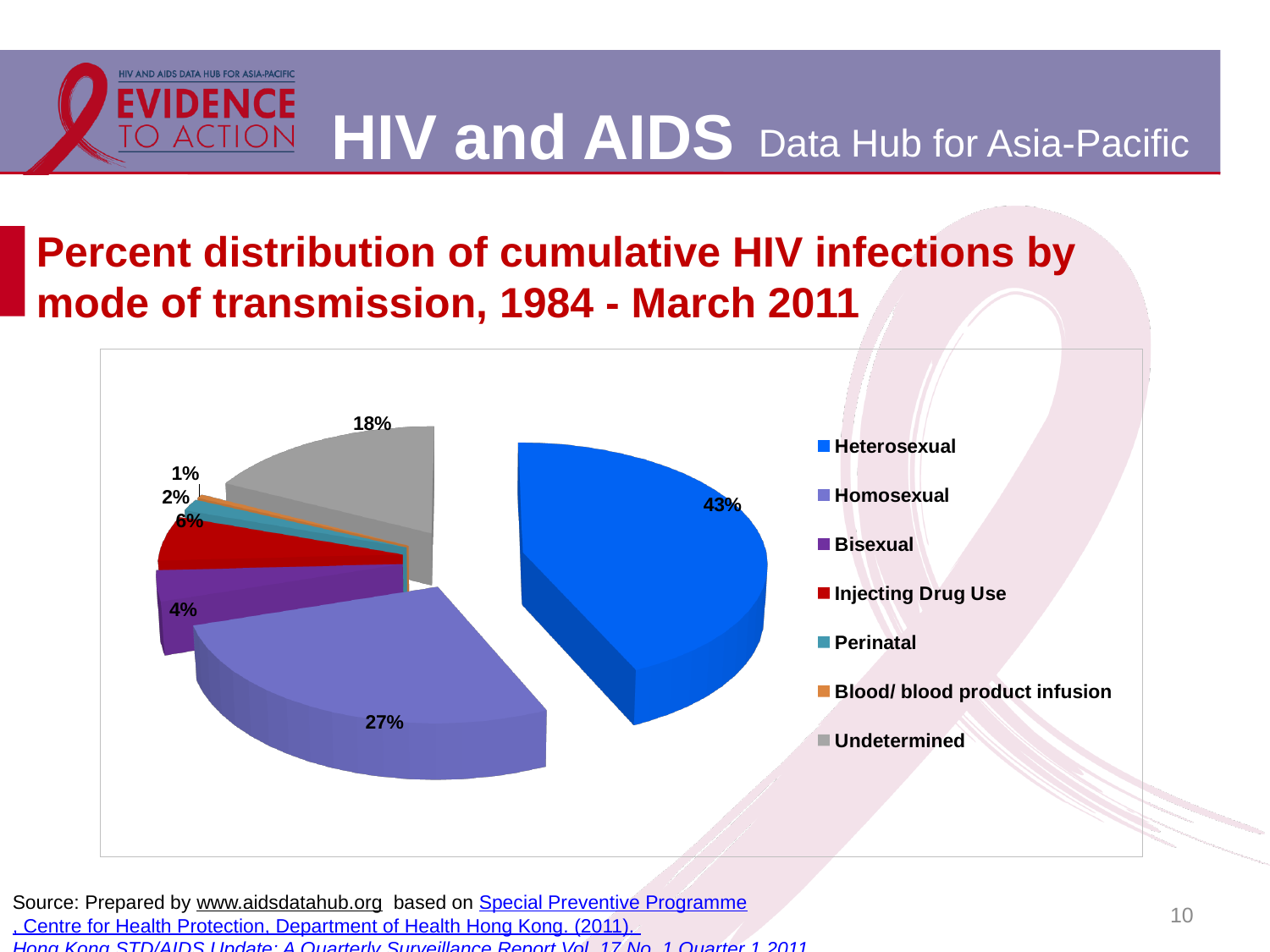
Which is larger, the share for Injecting Drug Use or the share for Bisexual? Injecting Drug Use Which mode of transmission has the largest share of the pie? Heterosexual What colour is the slice representing Injecting Drug Use? Red What kind of chart is shown on the slide? Pie chart How many modes of transmission are listed in the legend? 7 What is the difference in percentage points between Heterosexual and Homosexual transmission? 16 What percentage of cumulative HIV infections is attributed to Heterosexual transmission? 43% Which mode of transmission has the smallest share of the pie? Blood/ blood product infusion What percentage of cumulative HIV infections is attributed to Homosexual transmission? 27% What percentage is shown for the Undetermined category? 18% What percentage is shown for Bisexual transmission? 4% What percentage is shown for Injecting Drug Use? 6%